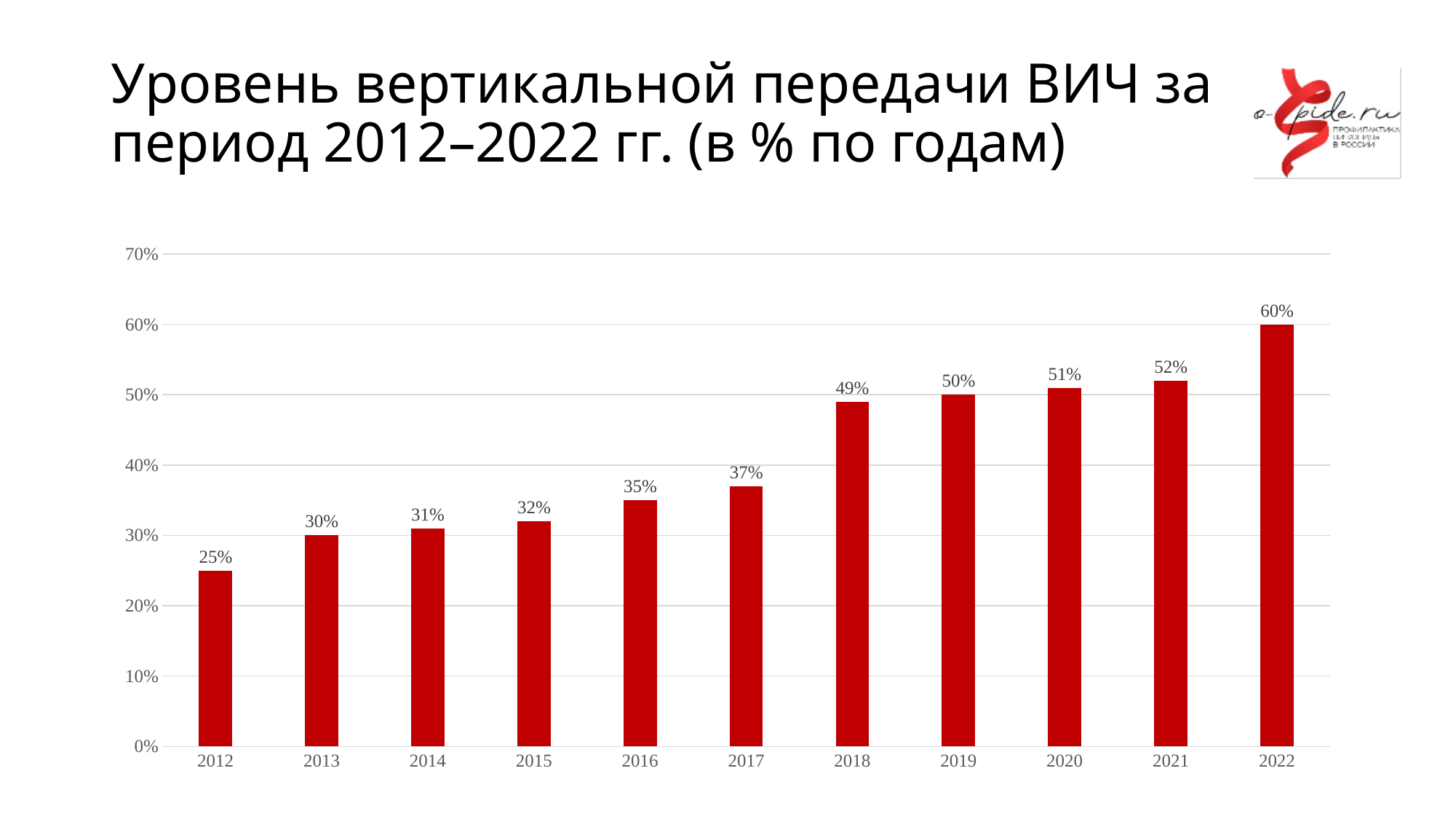
What kind of chart is this? bar chart What is the value for 2012? 25% Is the value for 2017 greater or less than 40%? less What is the difference between the values for 2018 and 2017? 12% What is the value for 2018? 49% What is the difference between the values for 2022 and 2012? 35% Do the values rise or fall from 2012 to 2022? rise What is the value for 2022? 60% Which year has the highest value? 2022 How many years are shown on the x axis? 11 Which is larger, the value for 2016 or the value for 2019? 2019 Which year has the lowest value? 2012